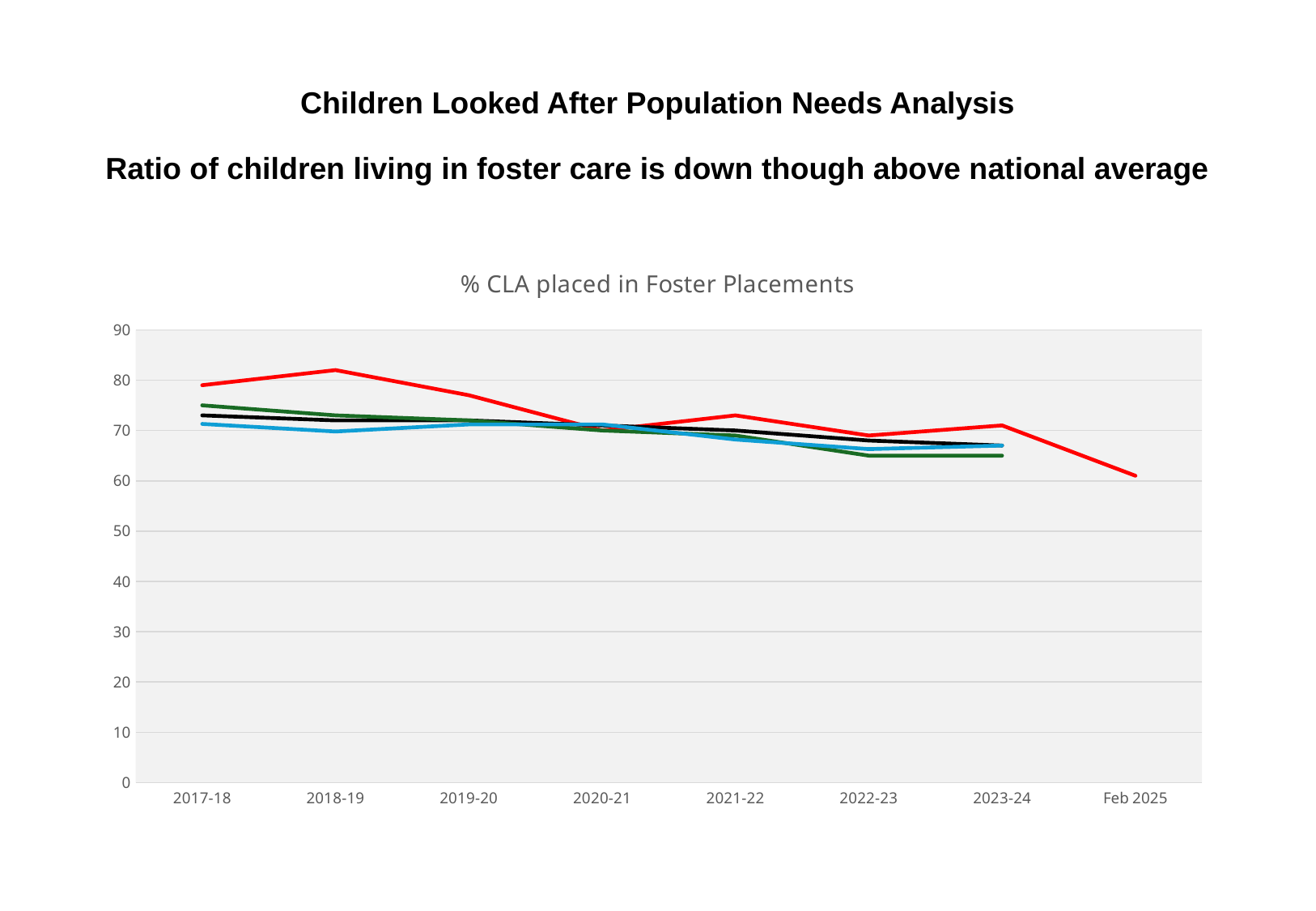
Is the value of the red line for Feb 2025 greater or less than 70? less What kind of chart is shown on the slide? line chart Which line has the highest value in 2017-18? the red line Which line is the only one that extends to Feb 2025? the red line How many time periods are labelled on the x axis of the chart? 8 Is the value of the green line for 2023-24 greater or less than 70? less Is the value of the red line for 2017-18 greater or less than 70? greater How many lines are plotted on the chart? 4 In which period does the red line reach its lowest value? Feb 2025 In which period does the red line reach its highest value? 2018-19 What is the title of the chart? % CLA placed in Foster Placements Does the red line generally rise or fall from 2018-19 to Feb 2025? fall